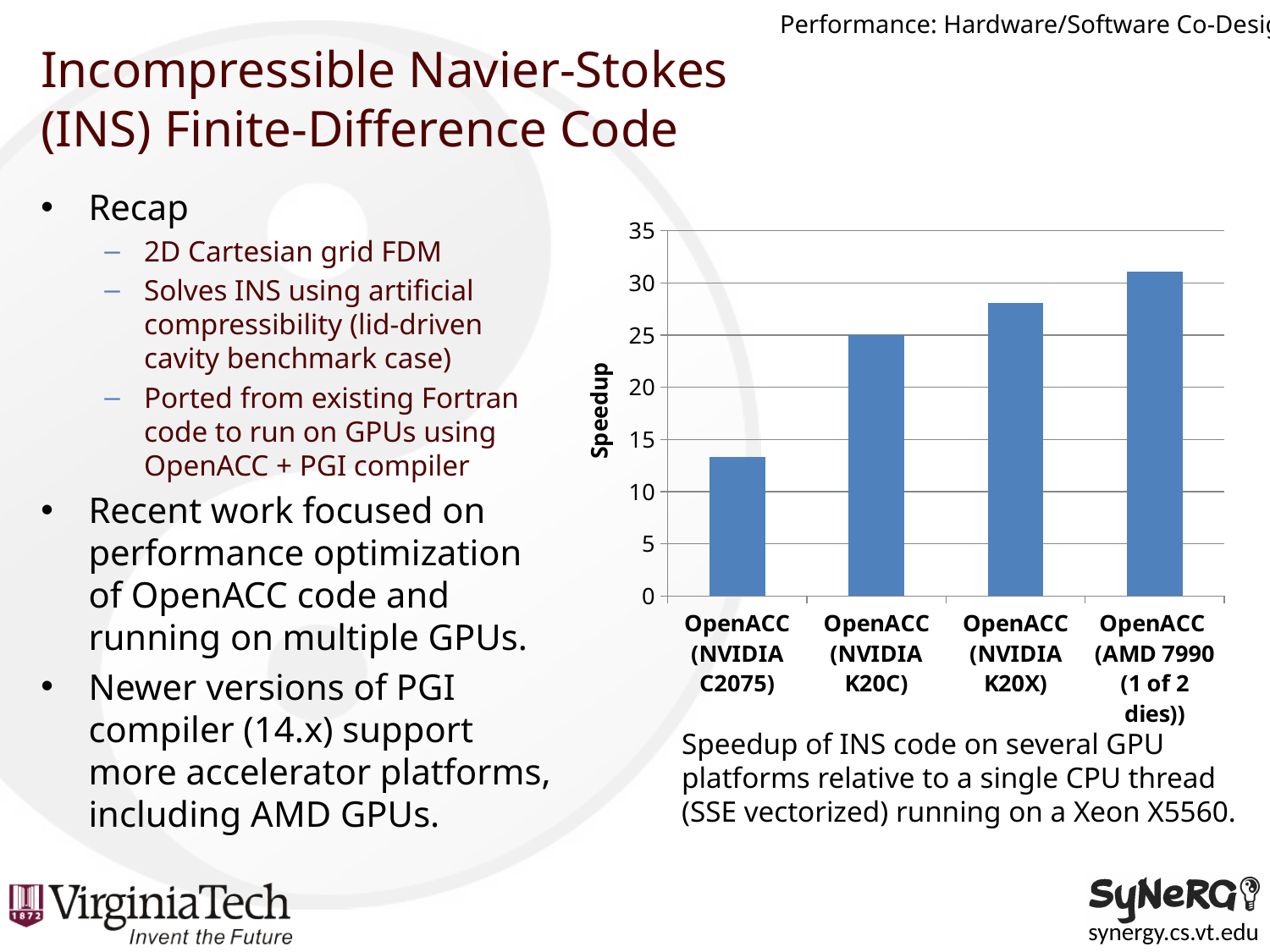
Is the speedup for OpenACC (NVIDIA C2075) greater or less than 15? less How many GPU platforms (bars) are plotted in the chart? 4 Which platform has the highest speedup in the chart? OpenACC (AMD 7990 (1 of 2 dies)) Is the speedup for OpenACC (AMD 7990 (1 of 2 dies)) greater or less than 30? greater Is the speedup for OpenACC (NVIDIA K20X) greater or less than 25? greater What kind of chart is shown on the slide? bar chart Do the speedup values rise or fall from left to right across the platforms? rise Which has a larger speedup, OpenACC (NVIDIA K20C) or OpenACC (NVIDIA K20X)? OpenACC (NVIDIA K20X) Which platform has the lowest speedup in the chart? OpenACC (NVIDIA C2075) Which has a larger speedup, OpenACC (NVIDIA C2075) or OpenACC (AMD 7990 (1 of 2 dies))? OpenACC (AMD 7990 (1 of 2 dies)) What is the label on the vertical axis of the chart? Speedup